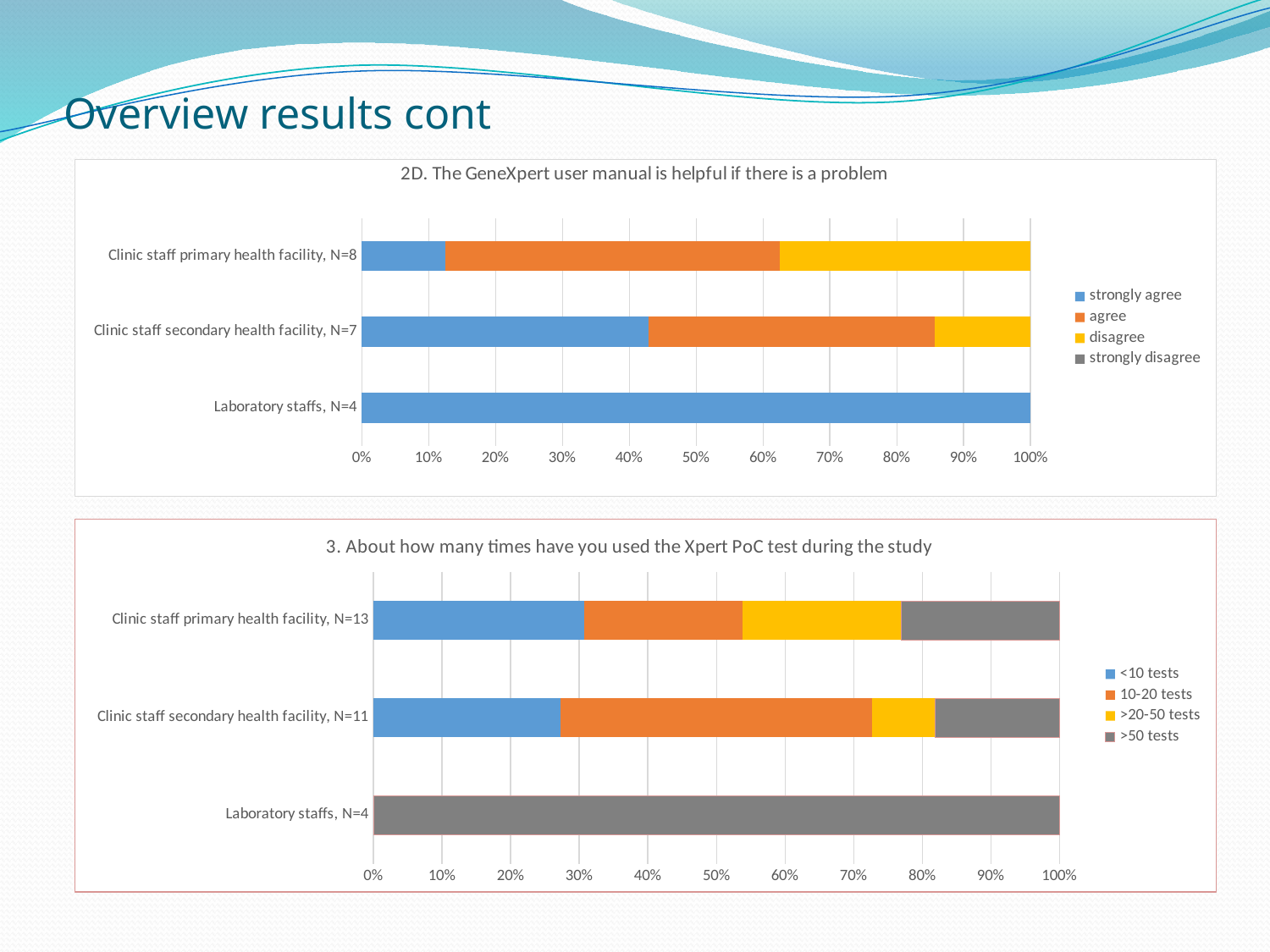
In the bottom chart, which colour represents >50 tests? grey In the top chart, which group has a larger strongly agree share: Clinic staff primary health facility, N=8 or Clinic staff secondary health facility, N=7? Clinic staff secondary health facility, N=7 In the top chart, which group has the largest strongly agree share? Laboratory staffs, N=4 In the bottom chart (3. About how many times have you used the Xpert PoC test during the study), how many series does the legend list? 4 In the top chart, is the strongly agree share for Clinic staff primary health facility, N=8 greater or less than 20%? less In the top chart, what kind of chart is shown? stacked bar chart In the top chart, how many respondent groups are plotted? 3 In the bottom chart, is the <10 tests share for Clinic staff primary health facility, N=13 greater or less than 20%? greater In the bottom chart, which group has a larger 10-20 tests share: Clinic staff primary health facility, N=13 or Clinic staff secondary health facility, N=11? Clinic staff secondary health facility, N=11 In the top chart (2D. The GeneXpert user manual is helpful if there is a problem), how many series does the legend list? 4 In the bottom chart, what share of Laboratory staffs, N=4 reported >50 tests? 100% In the top chart, what share of Laboratory staffs, N=4 answered strongly agree? 100%